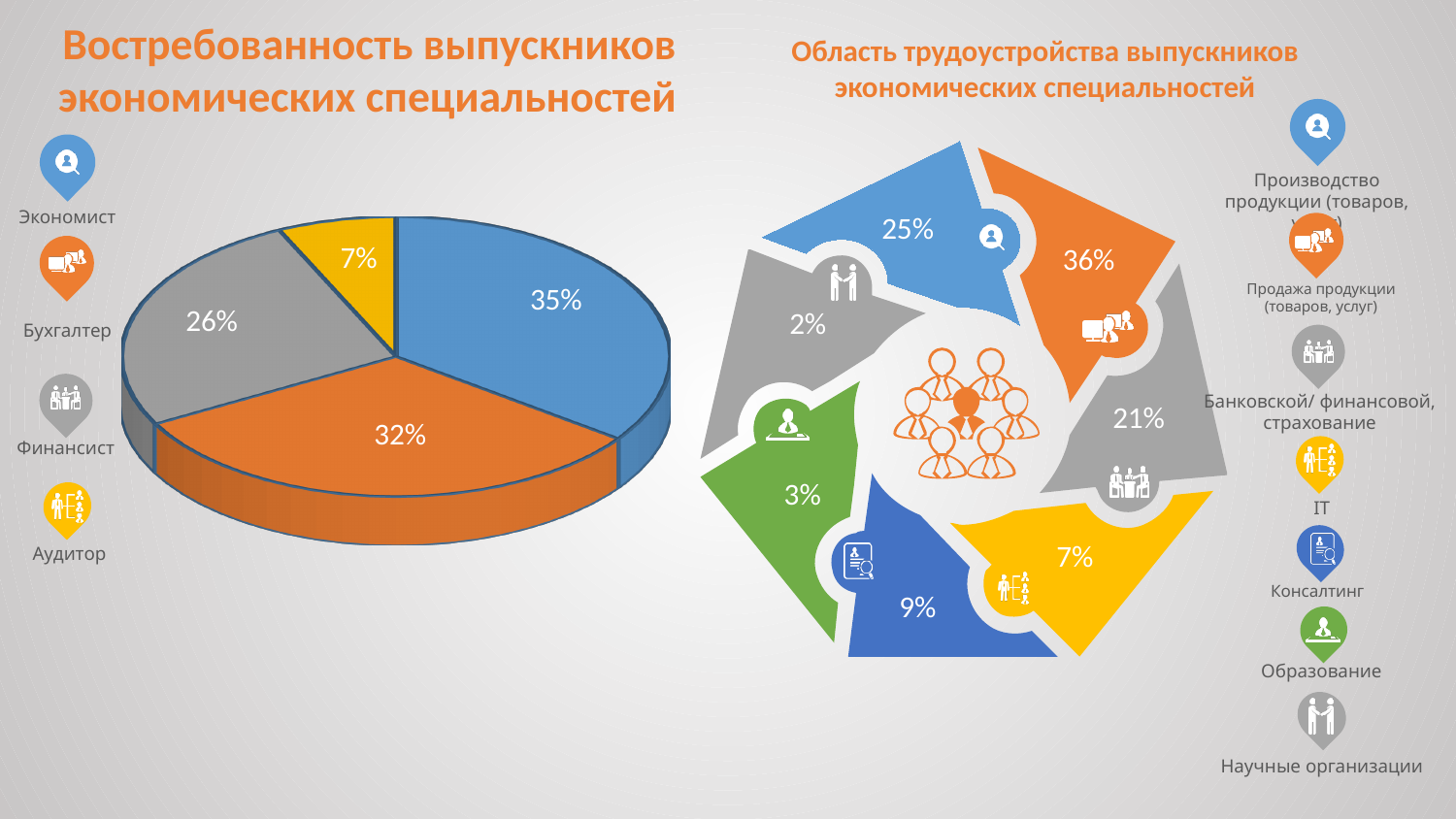
In the chart 'Востребованность выпускников экономических специальностей', which is larger: Бухгалтер or Финансист? Бухгалтер In the chart 'Востребованность выпускников экономических специальностей', what percentage is shown for Аудитор? 7% In the chart 'Востребованность выпускников экономических специальностей', what percentage is shown for Бухгалтер? 32% In the chart 'Востребованность выпускников экономических специальностей', which category has the largest slice? Экономист In the diagram 'Область трудоустройства выпускников экономических специальностей', what percentage is shown for Продажа продукции (товаров, услуг)? 36% In the chart 'Востребованность выпускников экономических специальностей', which category has the smallest slice? Аудитор In the chart 'Востребованность выпускников экономических специальностей', what percentage is shown for Экономист? 35% In the chart 'Востребованность выпускников экономических специальностей', what is the difference in percentage points between Экономист and Аудитор? 28 In the chart 'Востребованность выпускников экономических специальностей', what percentage is shown for Финансист? 26% What type of chart is 'Востребованность выпускников экономических специальностей'? Pie chart How many slices does the chart 'Востребованность выпускников экономических специальностей' have? 4 In the chart 'Востребованность выпускников экономических специальностей', what colour is the slice for Финансист? Gray